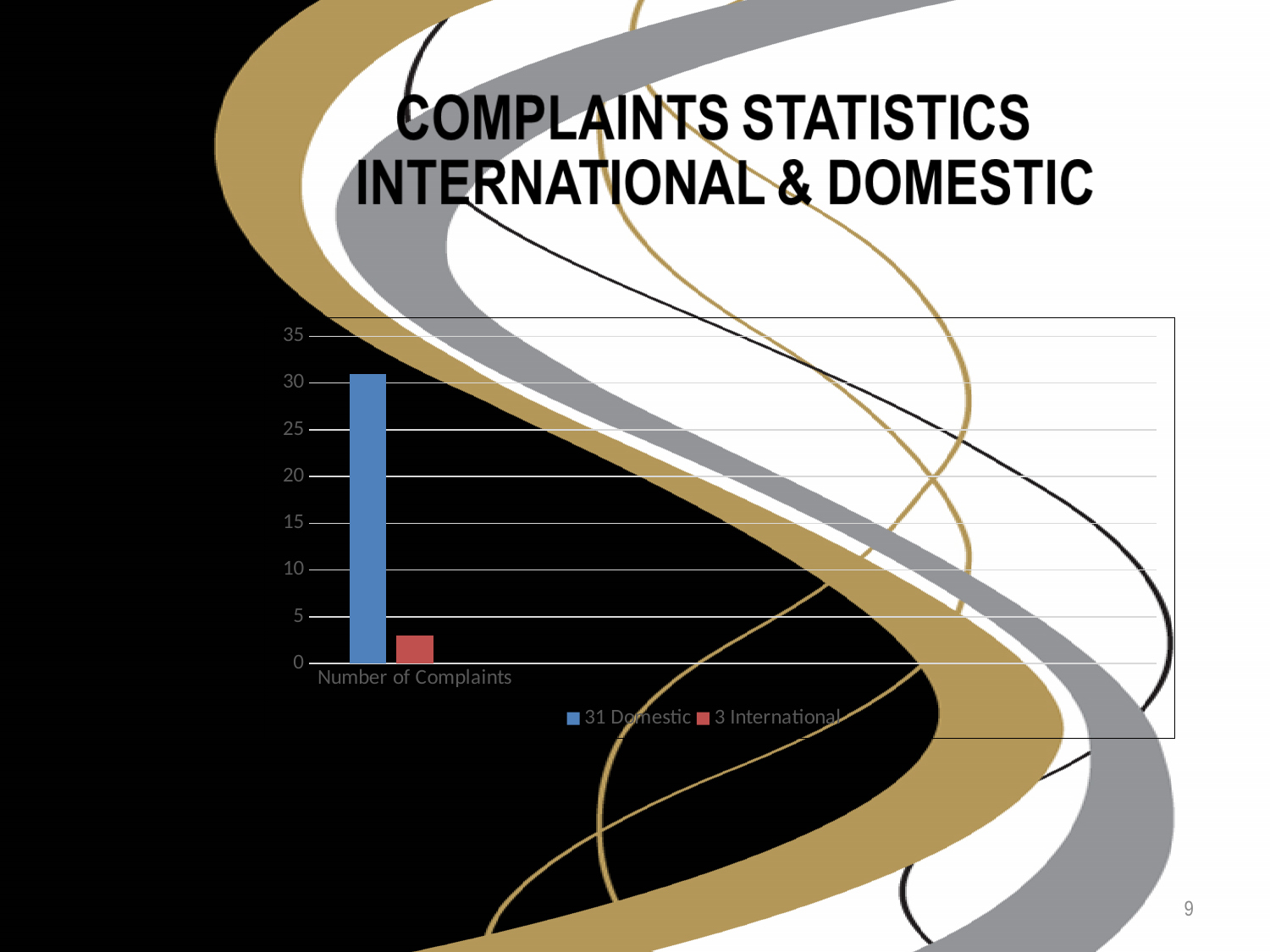
Which series has the lowest bar in the chart? 3 International What kind of chart is shown on the slide? bar chart Is the value of the International bar greater or less than 5? less Which series has the higher number of complaints, Domestic or International? Domestic Is the value of the Domestic bar greater or less than 30? greater What is the difference between the Domestic and International complaint counts? 28 What is the category label shown on the x axis of the chart? Number of Complaints How many series does the chart legend list? 2 How many categories are shown on the x axis of the chart? 1 What are the two series names listed in the chart legend? 31 Domestic and 3 International According to the legend, how many Domestic complaints are there? 31 According to the legend, how many International complaints are there? 3